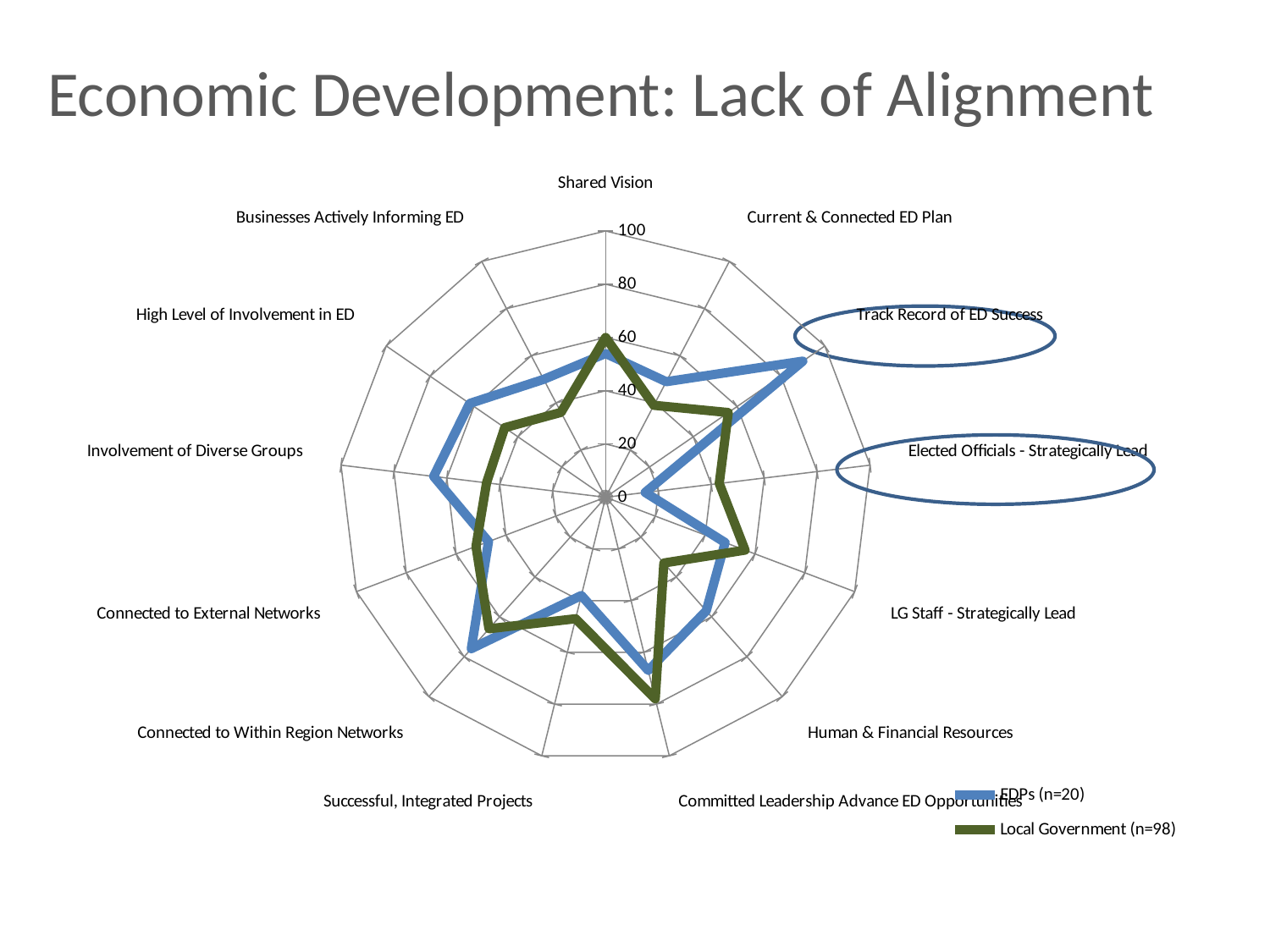
How many series does the legend list? 2 What are the two series named in the legend? EDPs (n=20) and Local Government (n=98) Is the EDPs (n=20) value for Track Record of ED Success greater or less than 60? greater Is the EDPs (n=20) value for Elected Officials - Strategically Lead greater or less than 20? less What kind of chart is shown on the slide? Radar chart For Human & Financial Resources, which series has the larger value, EDPs (n=20) or Local Government (n=98)? EDPs (n=20) How many categories (axes) does the radar chart have? 13 On which category does the EDPs (n=20) series have its lowest value? Elected Officials - Strategically Lead On which category does the EDPs (n=20) series reach its highest value? Track Record of ED Success What is the title of the slide? Economic Development: Lack of Alignment For Elected Officials - Strategically Lead, which series has the larger value, EDPs (n=20) or Local Government (n=98)? Local Government (n=98) For Track Record of ED Success, which series has the larger value, EDPs (n=20) or Local Government (n=98)? EDPs (n=20)